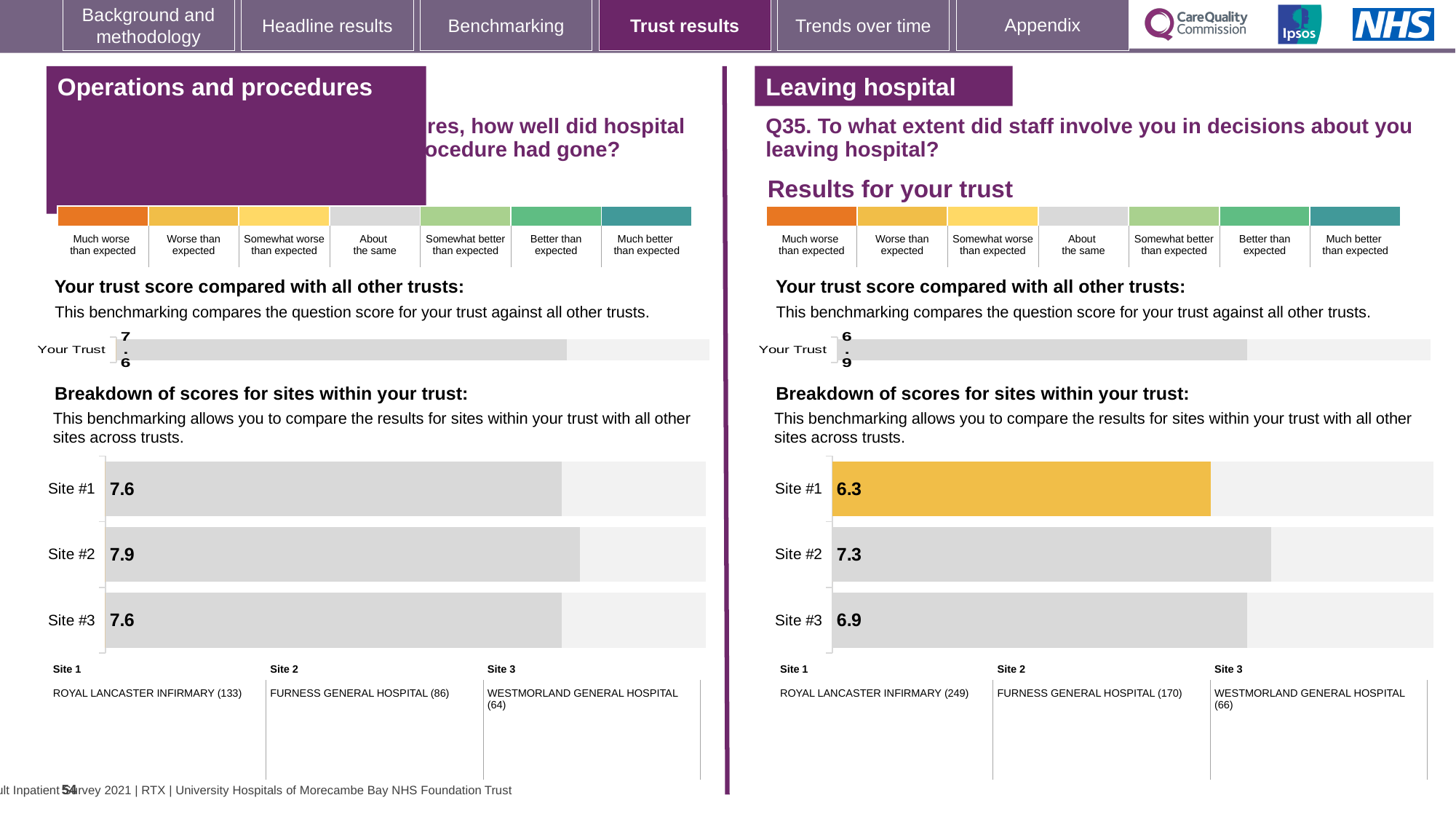
In the 'Operations and procedures' site breakdown chart on the left, which site has the highest score? Site #2 How many sites are shown in the 'Operations and procedures' site breakdown chart on the left? 3 In the 'Leaving hospital' site breakdown chart on the right, which site's bar is coloured yellow rather than grey? Site #1 In the 'Operations and procedures' site breakdown chart on the left, what is the score for Site #2? 7.9 In the 'Leaving hospital' site breakdown chart on the right, which site has the highest score? Site #2 In the 'Leaving hospital' site breakdown chart on the right, what is the score for Site #2? 7.3 What type of chart is used for the site breakdown in the 'Leaving hospital' section on the right? bar chart In the 'Leaving hospital' site breakdown chart on the right, what is the difference between the scores for Site #2 and Site #1? 1.0 In the 'Leaving hospital' site breakdown chart on the right, which site has the lowest score? Site #1 In the 'Operations and procedures' site breakdown chart on the left, what is the score for Site #3? 7.6 In the 'Operations and procedures' site breakdown chart on the left, what is the difference between the scores for Site #2 and Site #3? 0.3 In the 'Leaving hospital' site breakdown chart on the right, is the score for Site #3 larger or smaller than the score for Site #1? larger